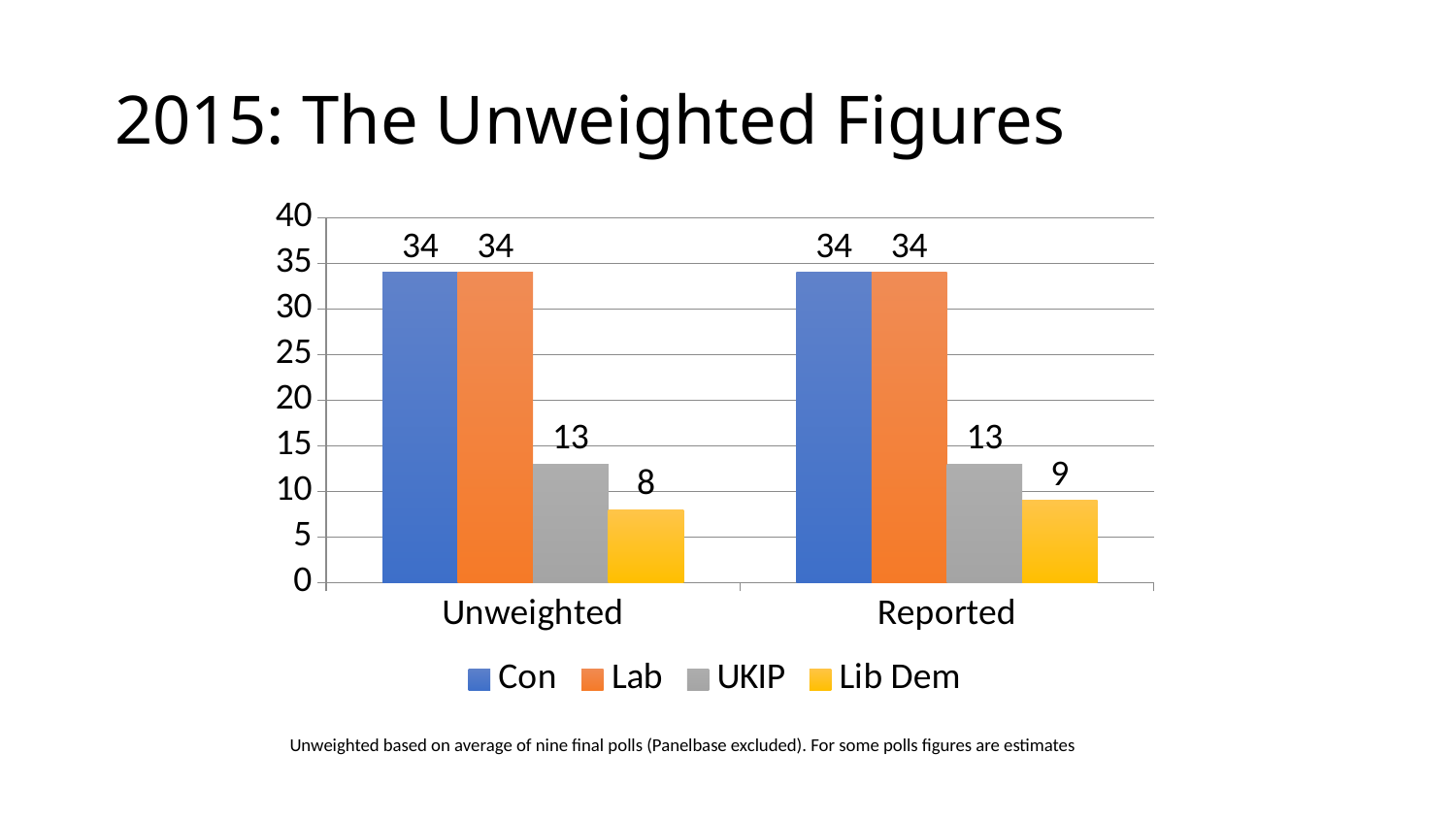
What is the value for Lib Dem in the Reported group? 9 What kind of chart is shown on the slide? Bar chart How many series does the legend list? 4 What is the difference between the Lib Dem values in the Reported and Unweighted groups? 1 What is the value for Lib Dem in the Unweighted group? 8 What is the difference between the UKIP and Lib Dem values in the Unweighted group? 5 Which party has the lowest value in the Unweighted group? Lib Dem How many categories are shown on the x axis? 2 What is the value for Con in the Unweighted group? 34 What is the value for UKIP in the Reported group? 13 What colour represents UKIP in the chart? Grey Which is larger in the Reported group, the UKIP value or the Lib Dem value? UKIP